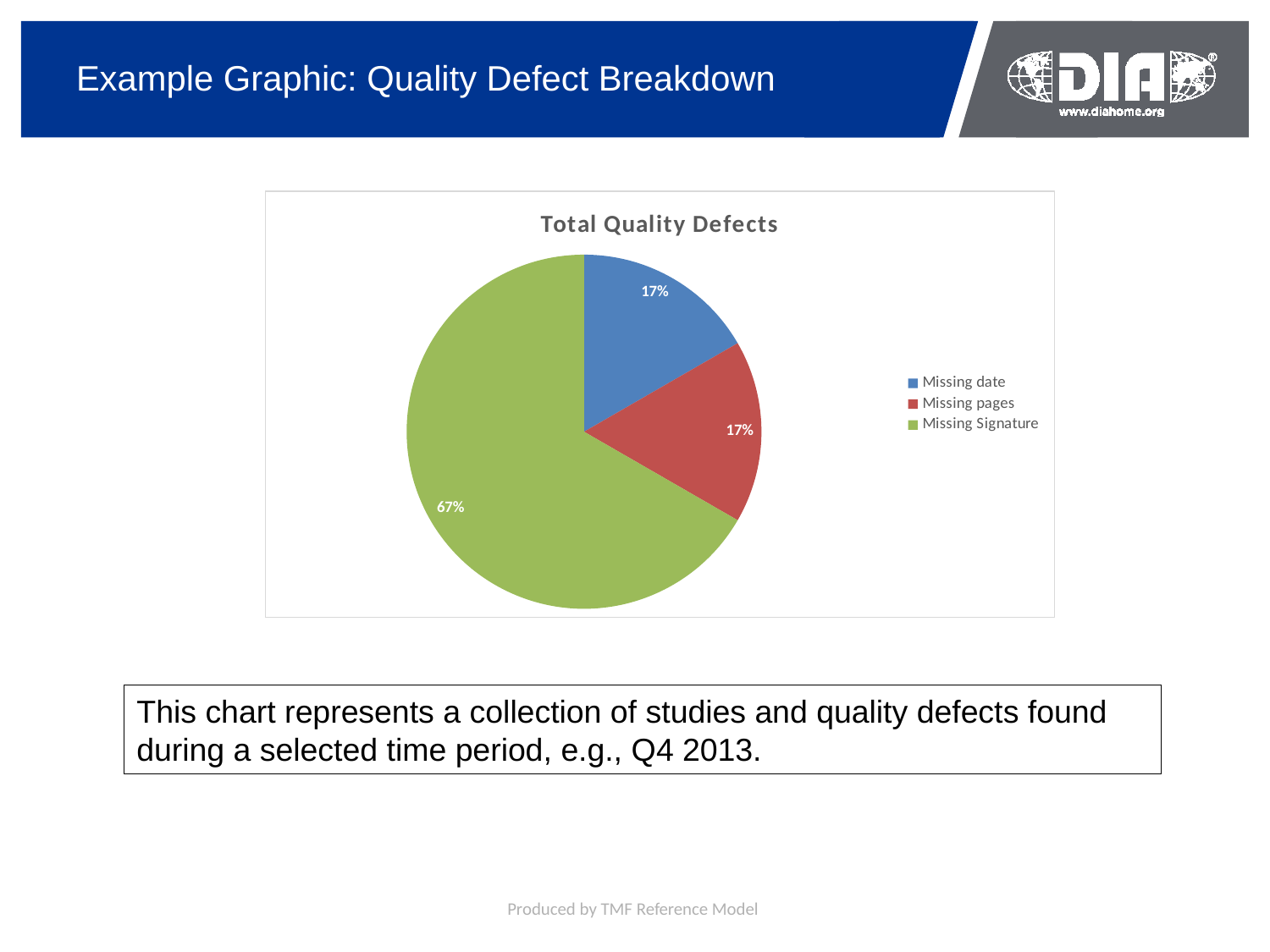
What colour is the Missing Signature slice? Green Which category has the largest slice of the pie? Missing Signature Which is larger, the slice for Missing Signature or the slice for Missing pages? Missing Signature What type of chart is shown on the slide? Pie chart How many categories does the legend list? 3 Is the share for Missing Signature greater or less than 50%? greater What is the difference between the Missing Signature share and the Missing date share? 50% What share of the pie does Missing Signature represent? 67% What share of the pie does Missing pages represent? 17% What share of the pie does Missing date represent? 17% What is the title of the chart? Total Quality Defects